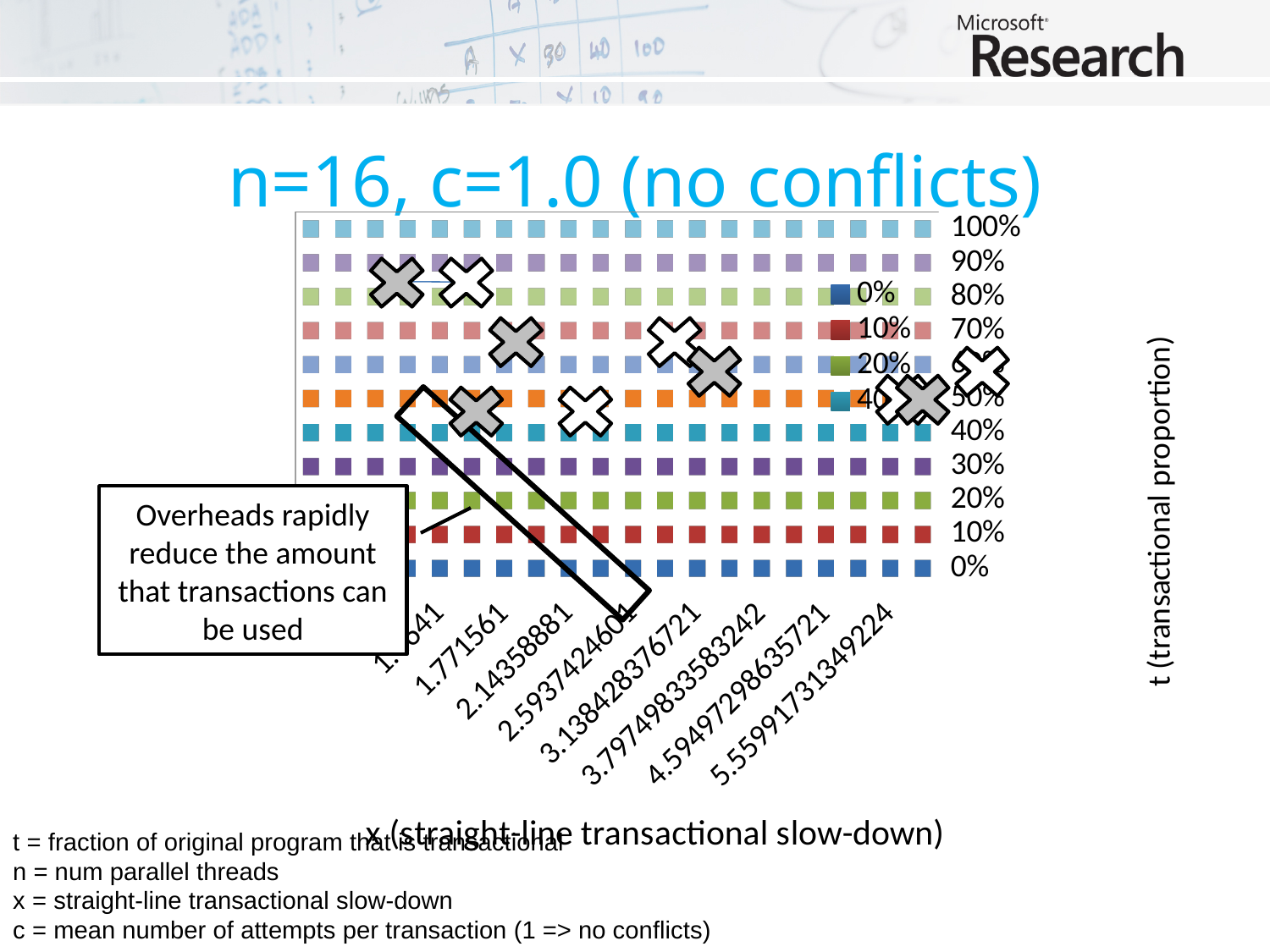
What is the highest t proportion series labelled on the chart? 100% How many series (t proportion levels) are labelled on the right side of the chart? 11 How many x-axis tick labels are shown along the bottom of the chart? 8 What is the largest x-axis tick label shown on the chart? 5.559917131349224 What is the title of the chart? n=16, c=1.0 (no conflicts) What is the label on the x axis of the chart? x (straight-line transactional slow-down) What is the lowest t proportion series labelled on the chart? 0%